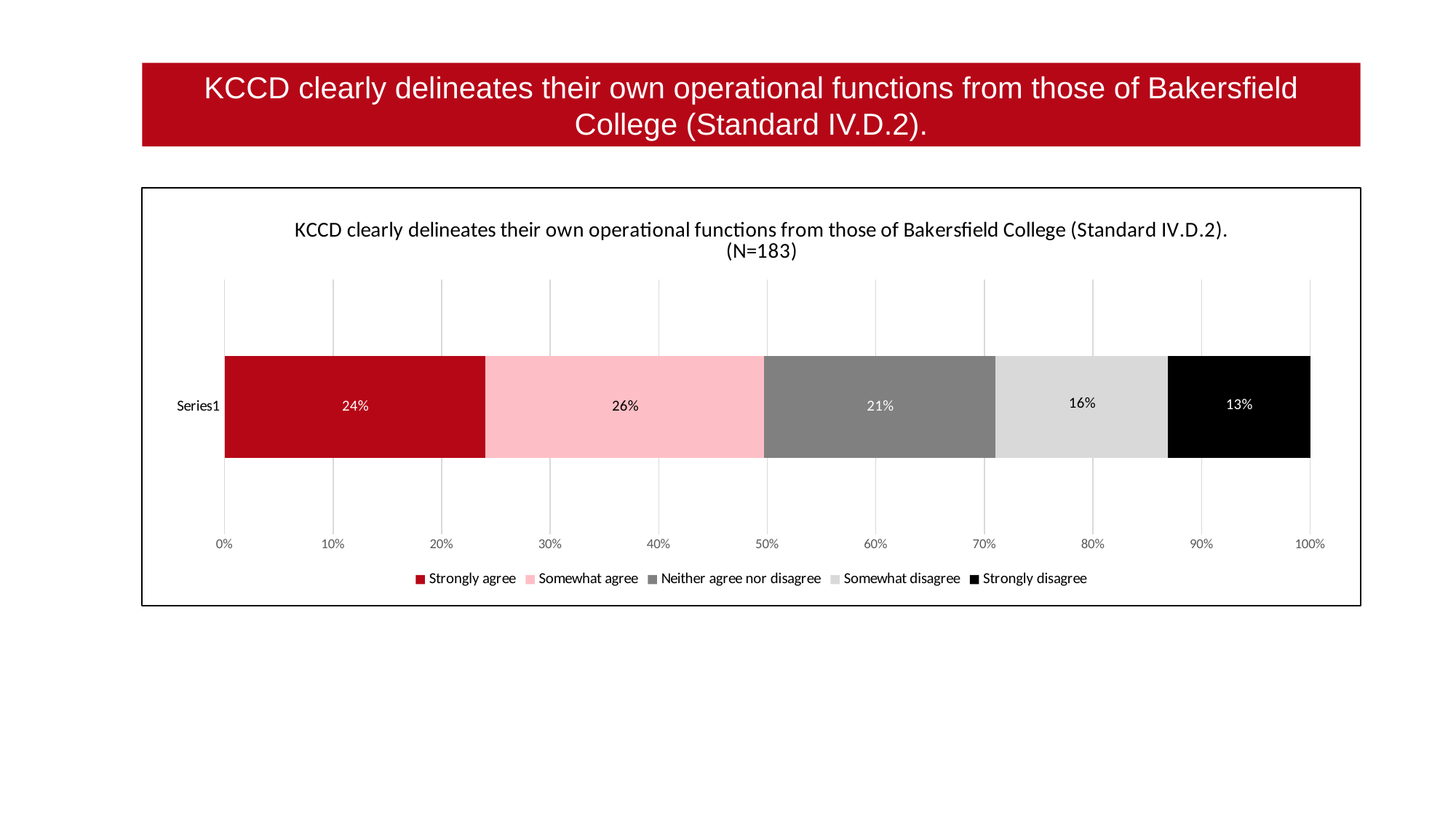
How many series does the legend list? 5 What is the sample size (N) shown in the chart title? 183 Which response option has the lowest percentage? Strongly disagree What percentage of respondents selected 'Strongly agree'? 24% What percentage of respondents selected 'Somewhat agree'? 26% What is the difference in percentage points between 'Somewhat agree' and 'Strongly disagree'? 13 What kind of chart is shown on the slide? Stacked bar chart What percentage of respondents selected 'Somewhat disagree'? 16% What percentage of respondents selected 'Neither agree nor disagree'? 21% Which response option has the highest percentage? Somewhat agree What percentage of respondents selected 'Strongly disagree'? 13% Which is larger, the percentage for 'Strongly agree' or for 'Neither agree nor disagree'? Strongly agree